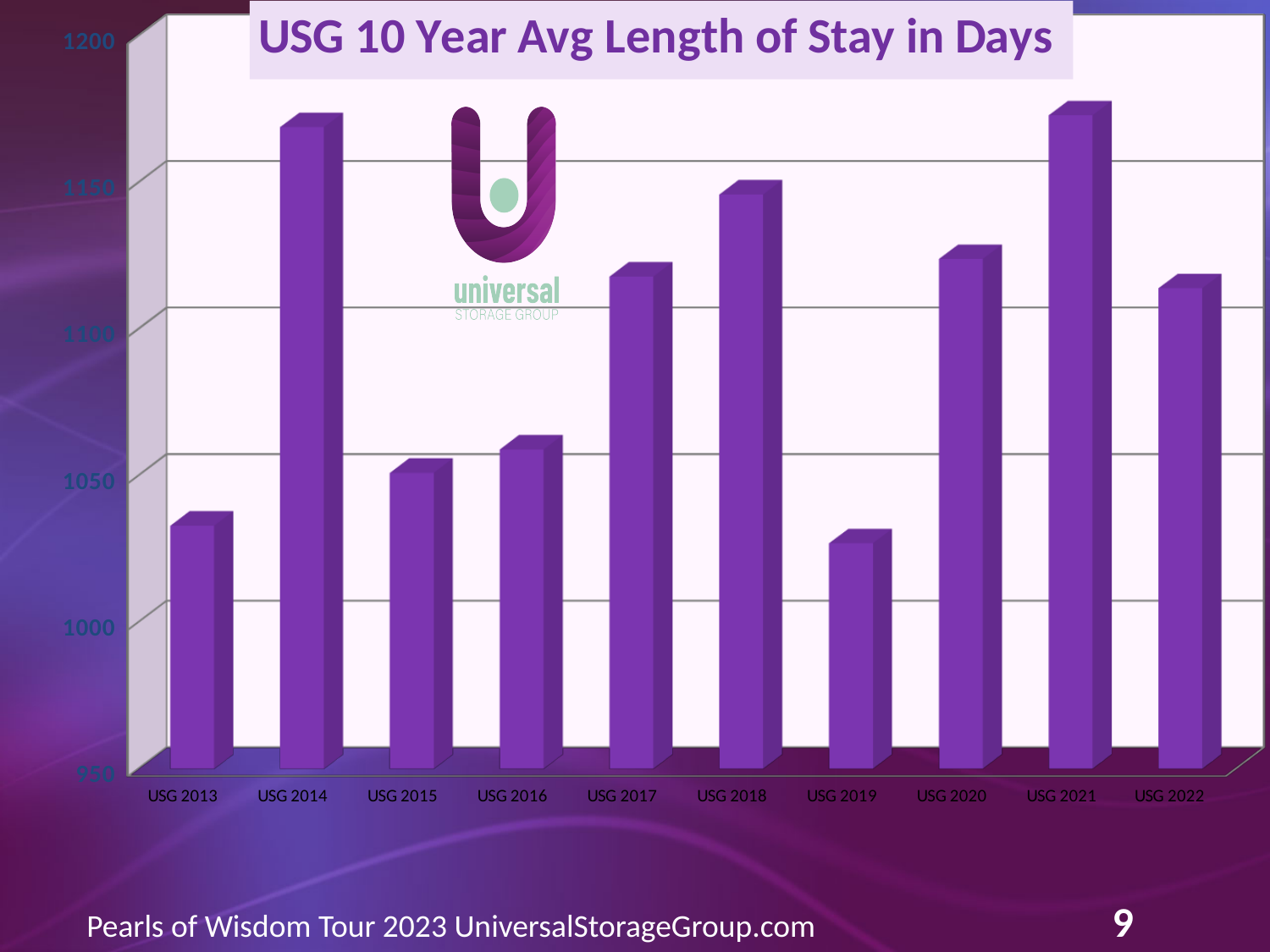
Is the value for USG 2017 greater or less than 1100? greater Is the value for USG 2019 greater or less than 1050? less Which is larger, the value for USG 2014 or USG 2013? USG 2014 How many categories (years) are plotted on the chart? 10 What is the title of the chart? USG 10 Year Avg Length of Stay in Days What kind of chart is shown on the slide? bar chart Which is larger, the value for USG 2018 or USG 2019? USG 2018 Is the value for USG 2013 greater or less than 1050? less Does the value rise or fall from USG 2018 to USG 2019? fall